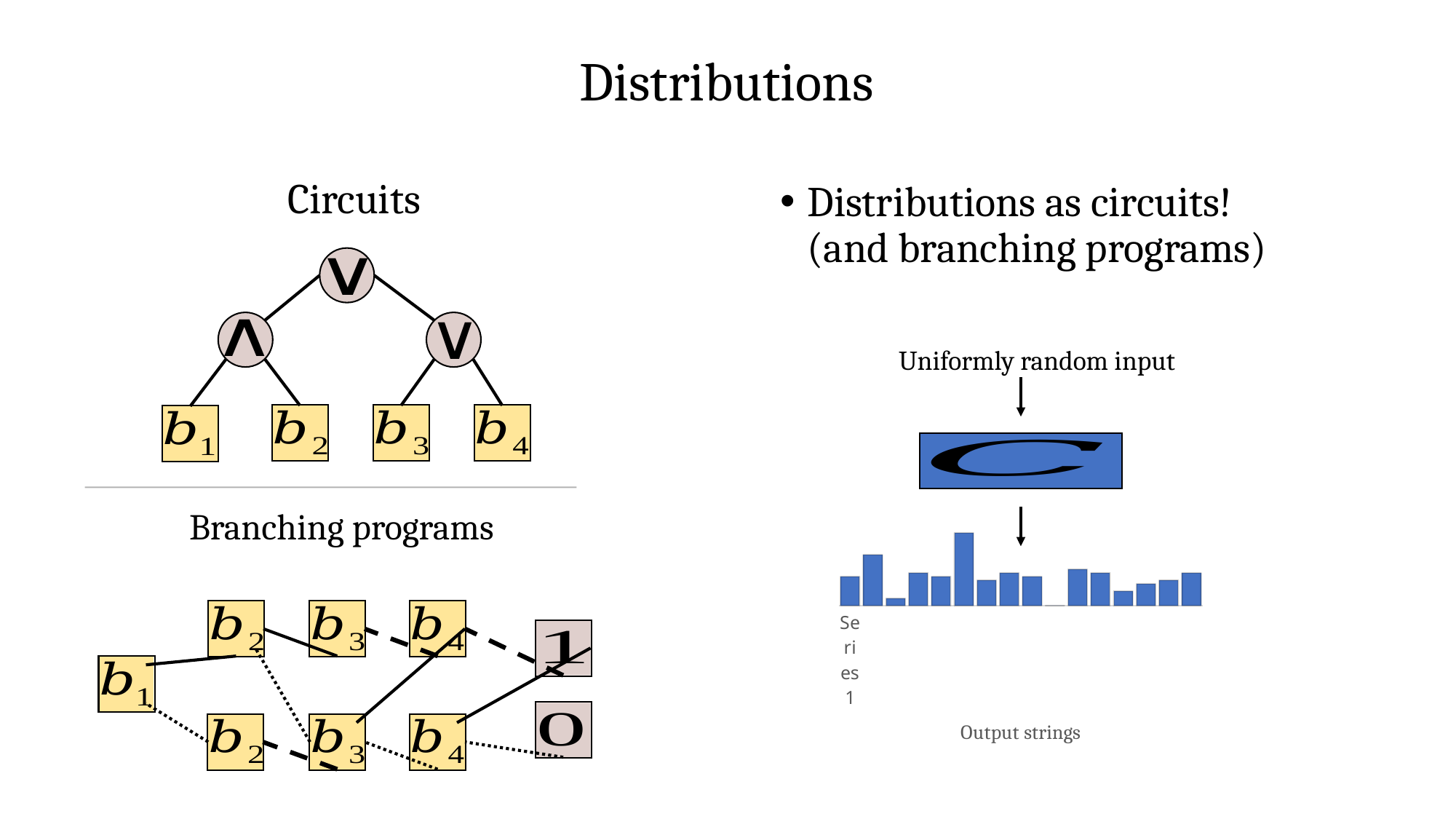
How many series does the legend of the bar chart list? 1 What kind of chart is shown under the arrow on the right side of the slide? bar chart In the bar chart, is the second bar from the left taller or shorter than the third bar from the left? taller What is the name of the series shown in the bar chart's legend? Series 1 What caption appears below the bar chart? Output strings Which bar in the bar chart is the tallest? the sixth bar from the left In the bar chart, is the sixth bar from the left taller or shorter than the first bar from the left? taller